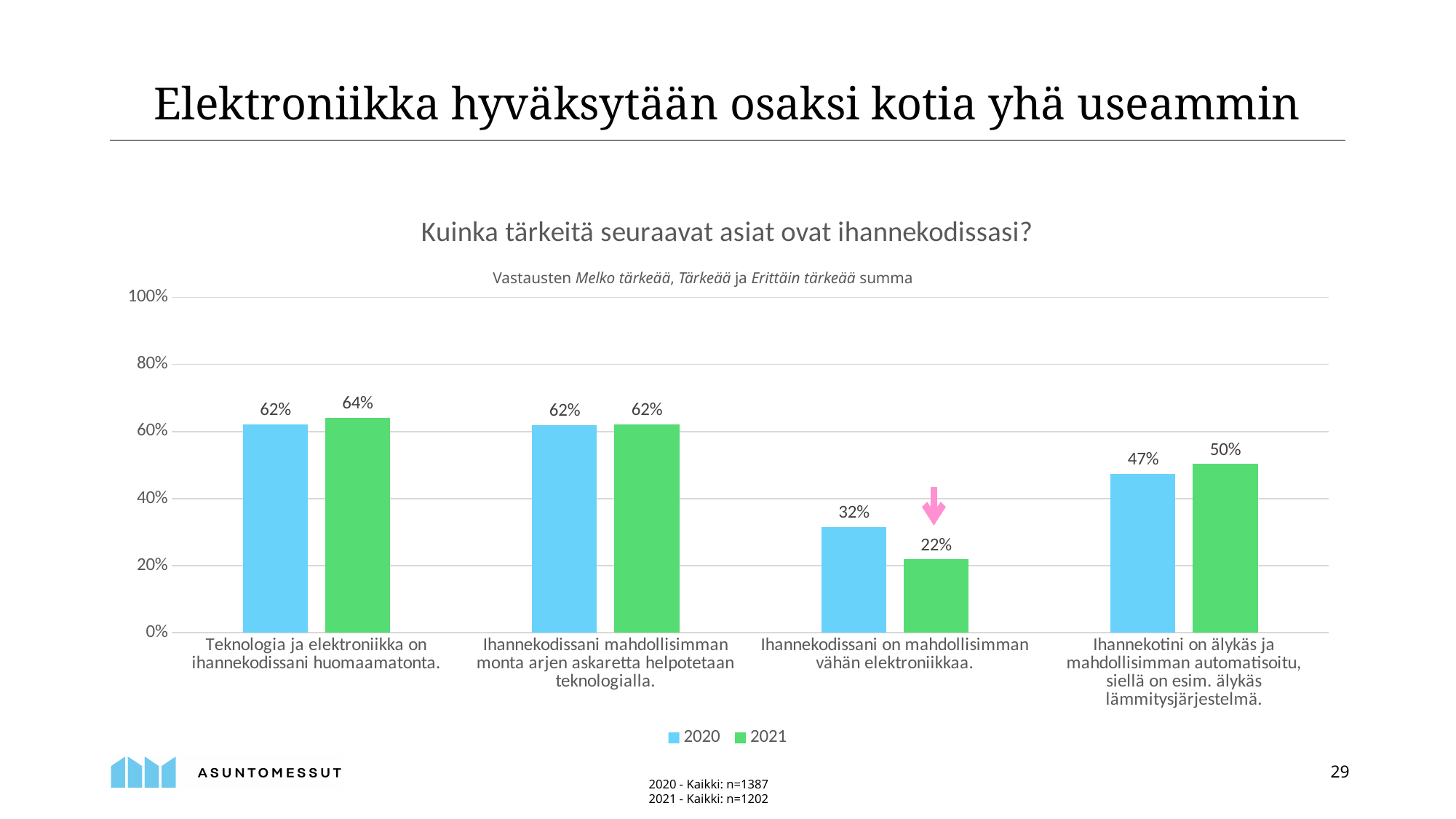
What is the 2021 value for "Ihannekotini on älykäs ja mahdollisimman automatisoitu, siellä on esim. älykäs lämmitysjärjestelmä."? 50% What is the 2021 value for "Teknologia ja elektroniikka on ihannekodissani huomaamatonta."? 64% Is the 2021 value for "Ihannekodissani on mahdollisimman vähän elektroniikkaa." greater or less than 40%? less What kind of chart is shown on the slide? bar chart Which is larger for "Teknologia ja elektroniikka on ihannekodissani huomaamatonta.": the 2020 value or the 2021 value? 2021 What is the 2020 value for "Ihannekodissani on mahdollisimman vähän elektroniikkaa."? 32% How many series does the legend list? 2 What is the difference between the 2020 and 2021 values for "Ihannekodissani on mahdollisimman vähän elektroniikkaa."? 10% What is the title of the chart? Kuinka tärkeitä seuraavat asiat ovat ihannekodissasi? How many categories are shown on the x axis? 4 Which category has the lowest 2021 value? Ihannekodissani on mahdollisimman vähän elektroniikkaa. What is the difference between the 2020 and 2021 values for "Ihannekotini on älykäs ja mahdollisimman automatisoitu, siellä on esim. älykäs lämmitysjärjestelmä."? 3%